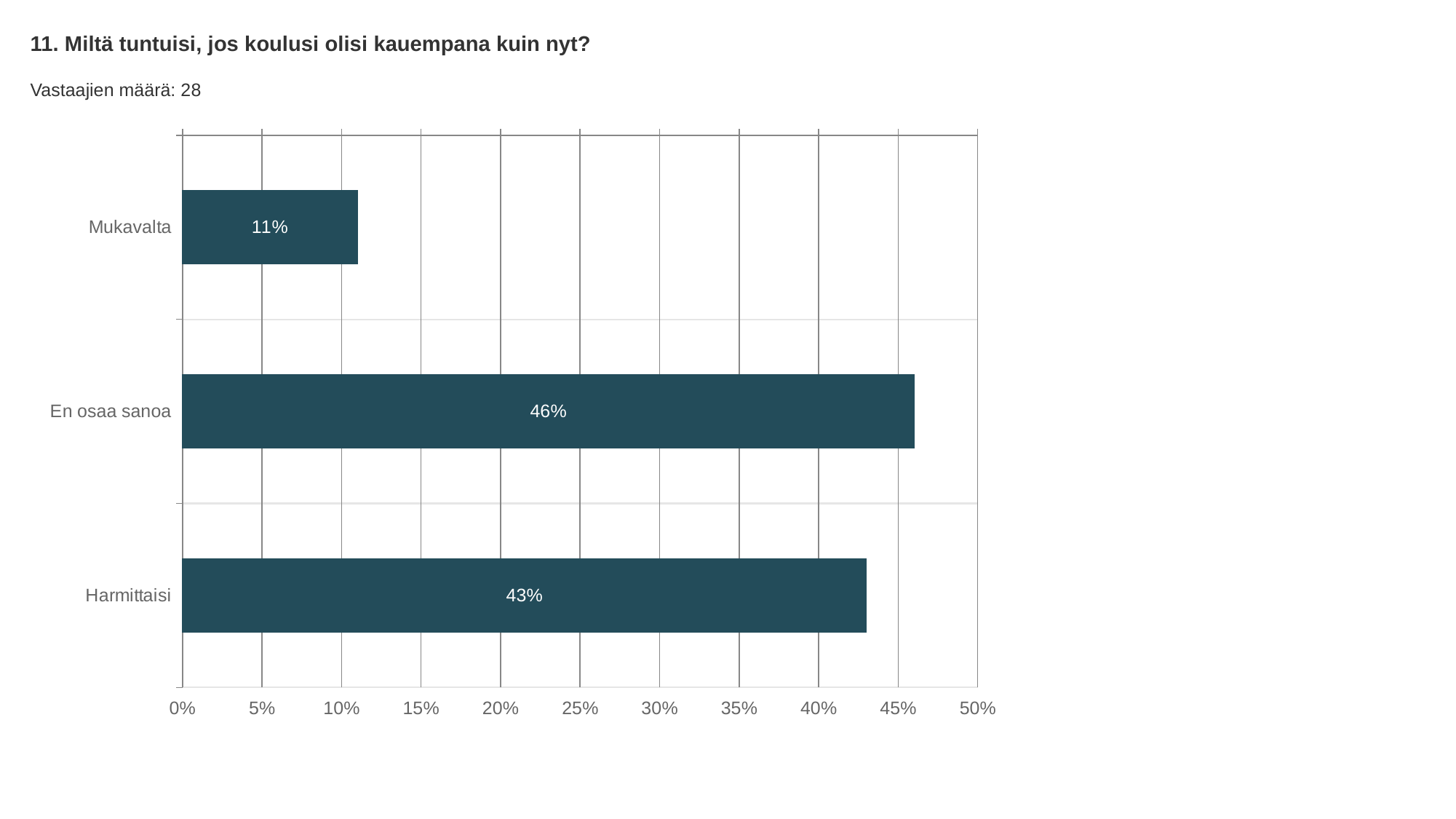
What kind of chart is shown on the slide? bar chart What is the difference between the values for En osaa sanoa and Harmittaisi? 3% Which category has the highest value? En osaa sanoa How many categories are shown in the chart? 3 Which category has the lowest value? Mukavalta Is the value for Harmittaisi greater or less than 40%? greater How many respondents does the slide report (Vastaajien määrä)? 28 What is the value for En osaa sanoa? 46% What is the difference between the values for Harmittaisi and Mukavalta? 32% What is the value for Harmittaisi? 43% What is the value for Mukavalta? 11% Which is larger, the value for Harmittaisi or the value for Mukavalta? Harmittaisi